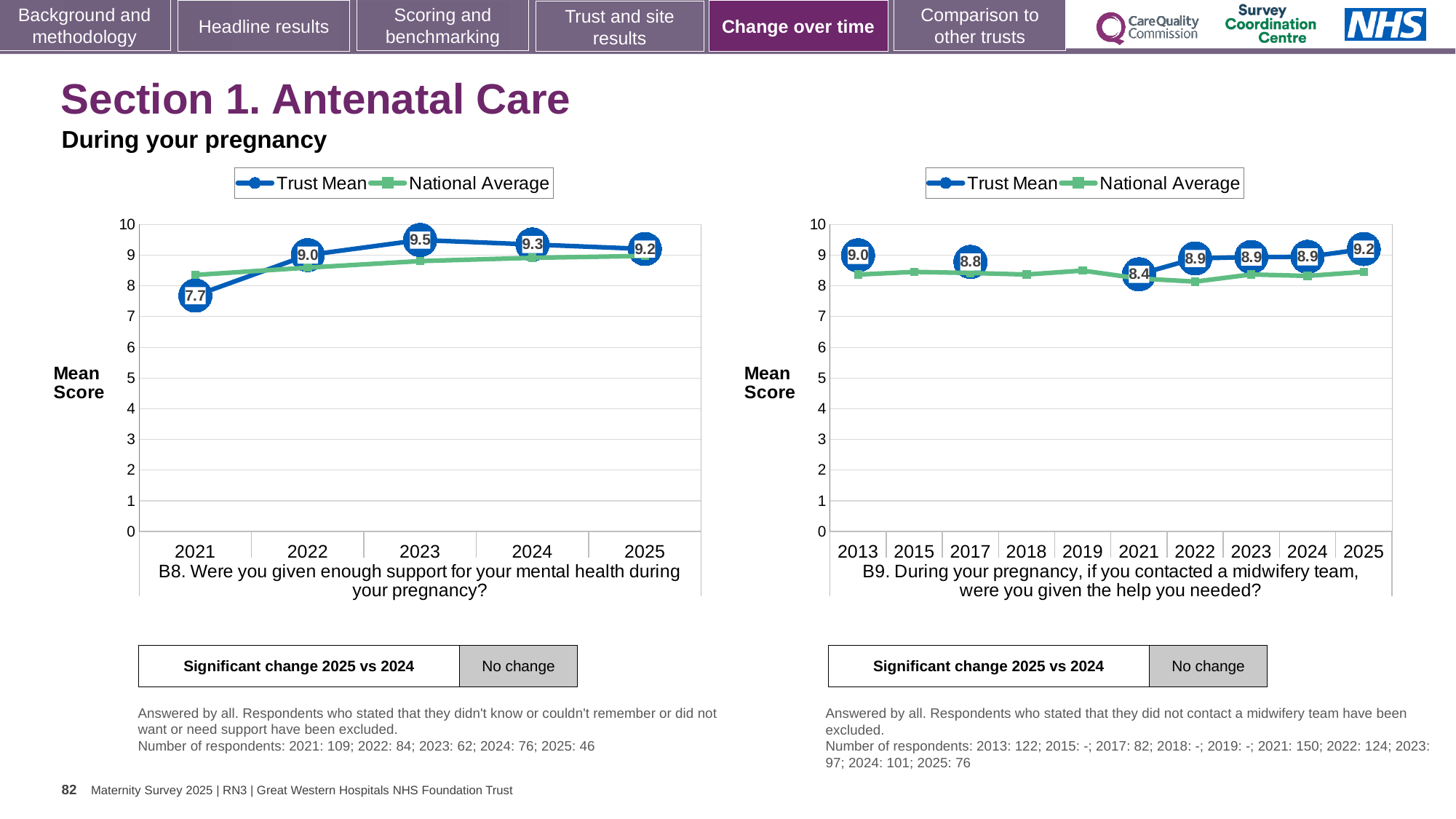
In the B9 chart on the right, which year has the lowest Trust Mean? 2021 In the B8 chart on the left, which year has the lowest Trust Mean? 2021 In the B8 chart on the left, what is the Trust Mean for 2023? 9.5 In the B8 chart on the left, is the National Average for 2021 greater or less than 8? greater What kind of chart is the B9 chart on the right? Line chart In the B9 chart on the right, how many series does the legend list? 2 In the B9 chart on the right, what is the Trust Mean for 2021? 8.4 In the B8 chart on the left, what is the difference between the Trust Mean in 2023 and in 2021? 1.8 In the B9 chart on the right, what is the Trust Mean for 2025? 9.2 In the B8 chart on the left, how many years are shown on the x axis? 5 In the B8 chart on the left, what is the Trust Mean for 2021? 7.7 In the B8 chart on the left, which year has the highest Trust Mean? 2023